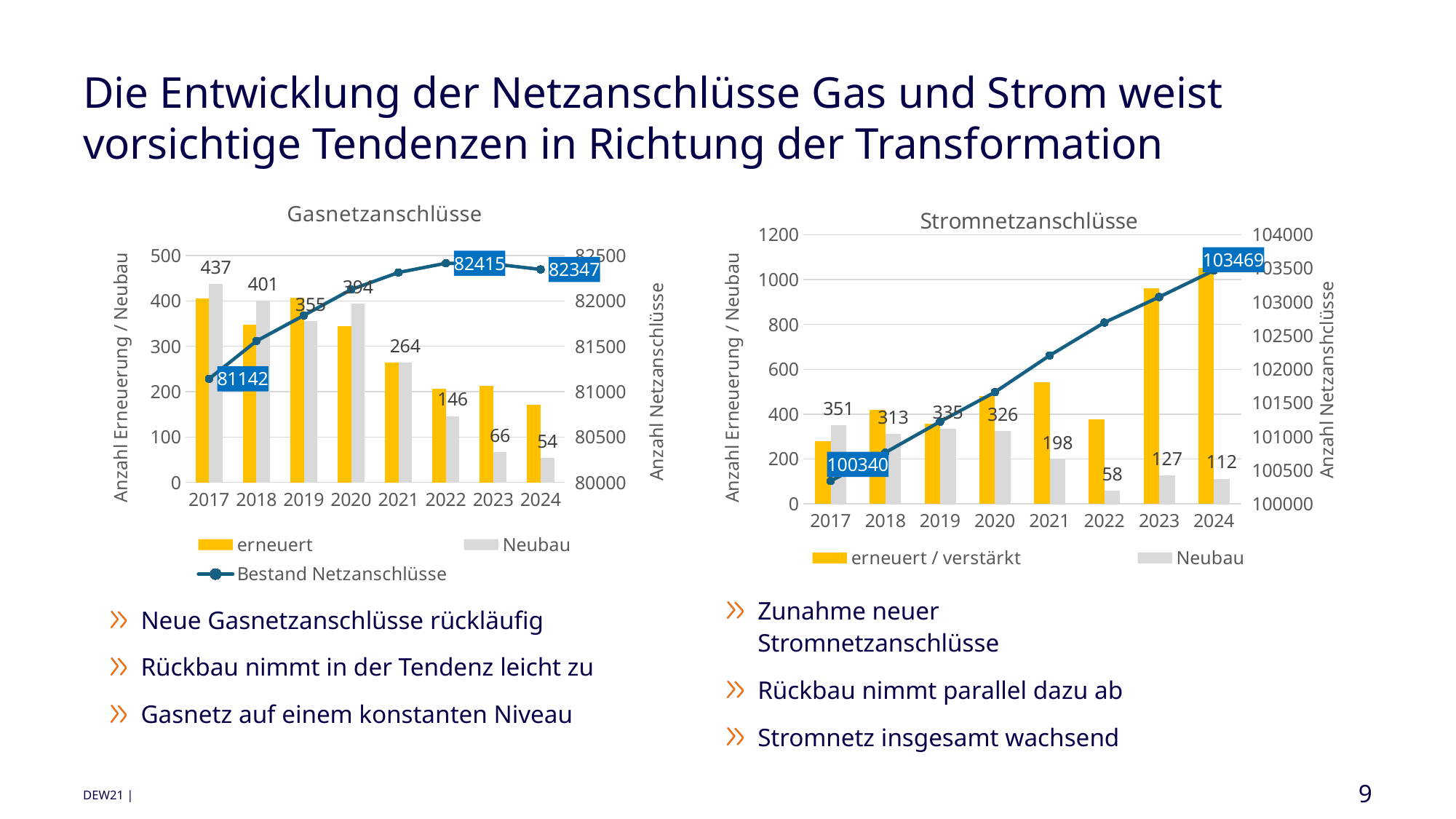
How many years are shown on the x axis of the Gasnetzanschlüsse chart? 8 In the Gasnetzanschlüsse chart, what is the Bestand Netzanschlüsse value labelled for 2017? 81142 How many series does the legend of the Gasnetzanschlüsse chart list? 3 In the Stromnetzanschlüsse chart, which year has the lowest Neubau value? 2022 In the Gasnetzanschlüsse chart, what is the Neubau value for 2017? 437 In the Stromnetzanschlüsse chart, does the line series rise or fall from 2017 to 2024? rise In the Gasnetzanschlüsse chart, what is the difference between the Neubau values for 2017 and 2024? 383 In the Gasnetzanschlüsse chart, which year has the lowest Neubau value? 2024 In the Stromnetzanschlüsse chart, is the erneuert / verstärkt value for 2024 greater or less than 1000? greater In the Gasnetzanschlüsse chart, is the Bestand Netzanschlüsse value higher in 2022 or in 2024? 2022 In the Stromnetzanschlüsse chart, what value is labelled on the line for 2024? 103469 In the Stromnetzanschlüsse chart, what is the Neubau value for 2021? 198